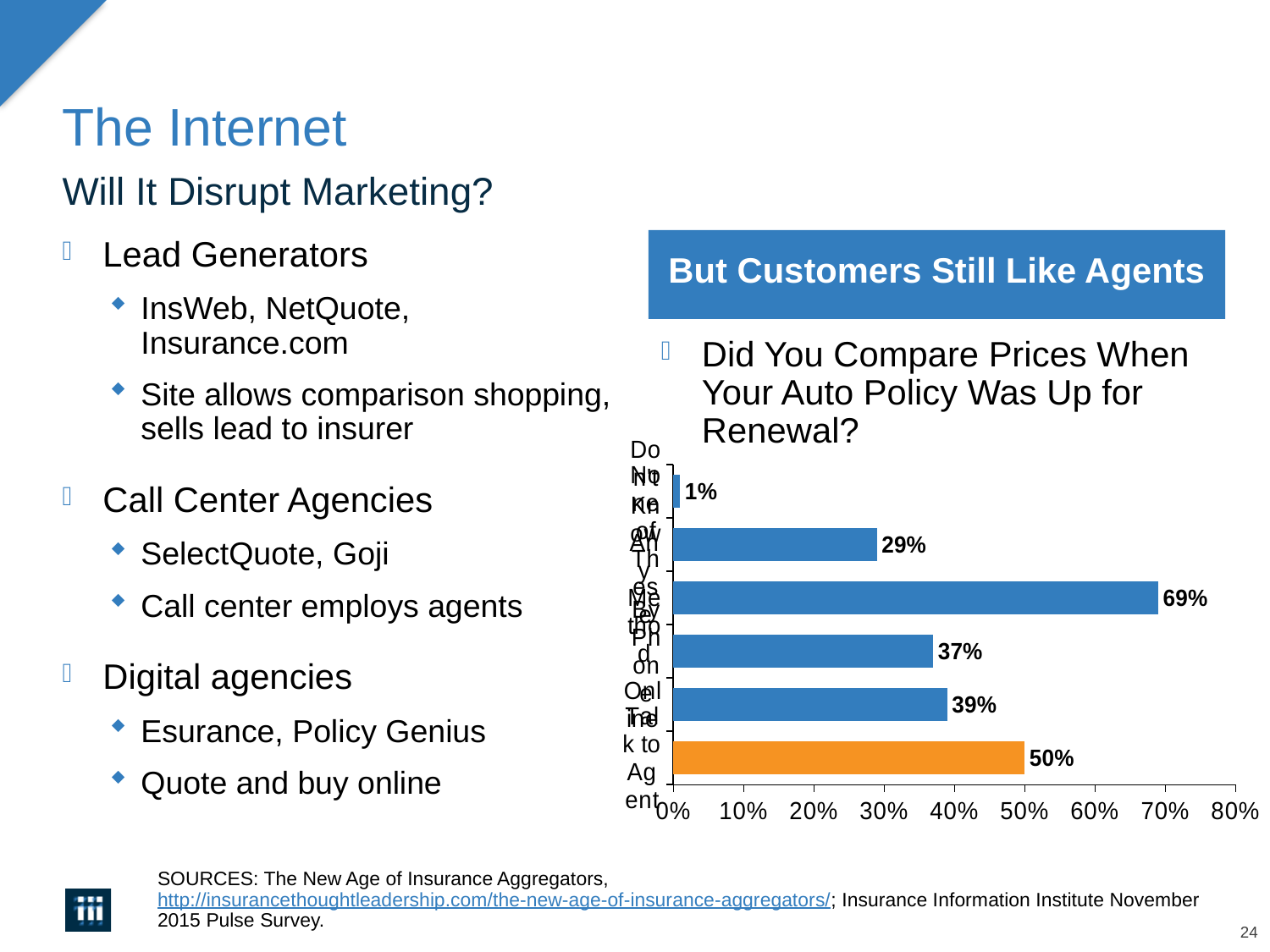
Which is larger: the bar labeled 37% or the bar labeled 39%? 39% What value is labeled on the second bar from the top of the chart? 29% What value is labeled on the topmost bar of the chart? 1% What is the heading in the blue box above the chart? But Customers Still Like Agents What is the maximum value shown on the horizontal axis of the chart? 80% What is the lowest value shown among the bars in the chart? 1% Is the value of the longest bar in the chart greater or less than 60%? greater What type of chart is shown on the slide? bar chart How many bars are plotted in the chart? 6 What is the difference between the longest bar (69%) and the orange bar (50%)? 19% What is the highest value shown among the bars in the chart? 69% What value is labeled on the orange bar at the bottom of the chart? 50%